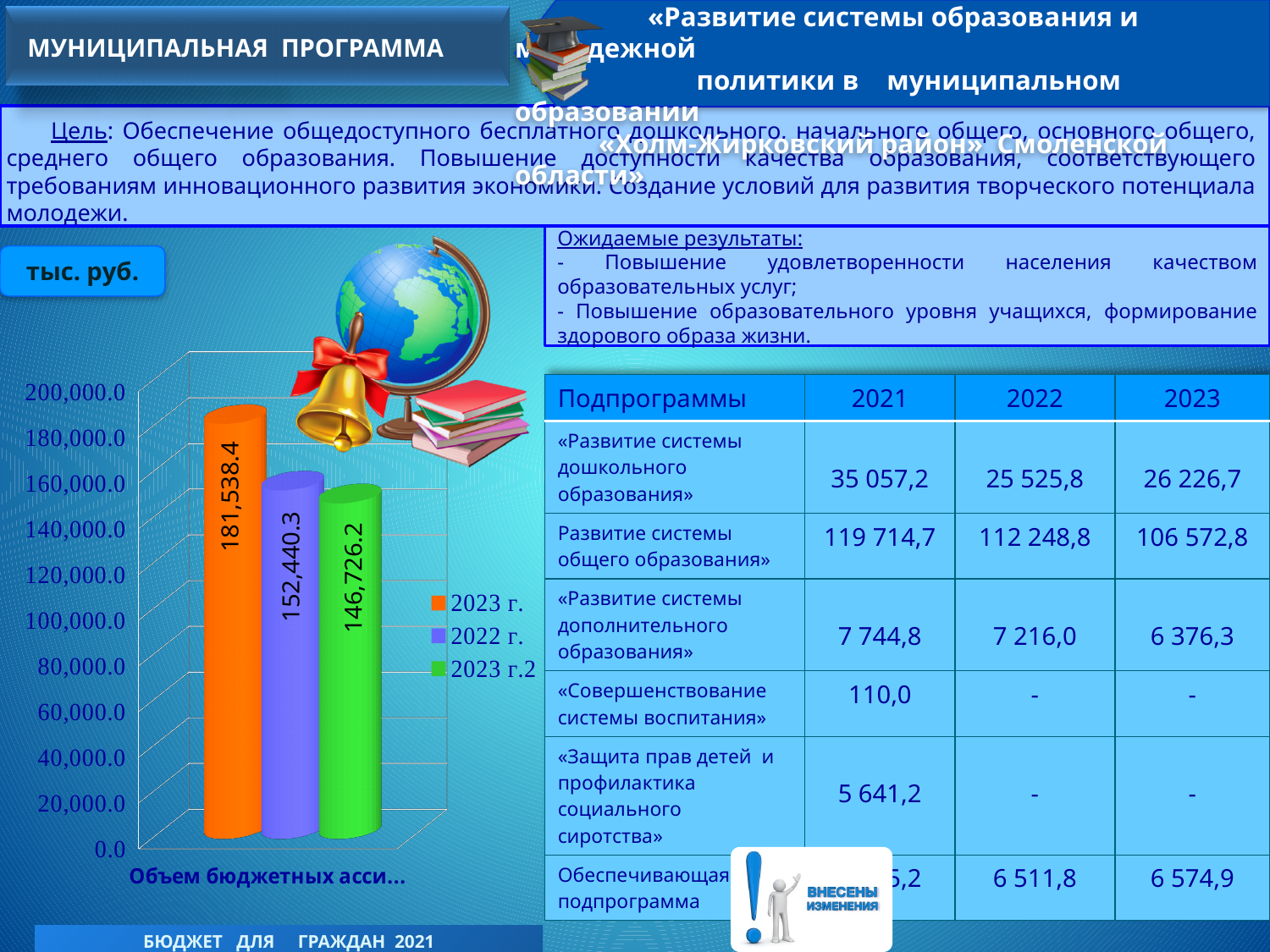
Is the value of the orange bar greater or less than 160,000.0? greater What is the difference between the orange bar (181,538.4) and the blue bar (152,440.3)? 29,098.1 How many entries does the chart legend list? 3 What is the difference between the blue bar (152,440.3) and the green bar (146,726.2)? 5,714.1 What value is shown on the blue bar (legend entry "2022 г.") in the bar chart? 152,440.3 What value is shown on the orange bar (legend entry "2023 г.") in the bar chart? 181,538.4 Which bar in the chart has the highest value? The orange bar (2023 г.), 181,538.4 Which bar in the chart has the lowest value? The green bar (2023 г.2), 146,726.2 What type of chart is shown on the left of the slide? Bar chart What value is shown on the green bar (legend entry "2023 г.2") in the bar chart? 146,726.2 How many bars are plotted in the chart? 3 Which is larger in the chart: the orange bar or the green bar? The orange bar